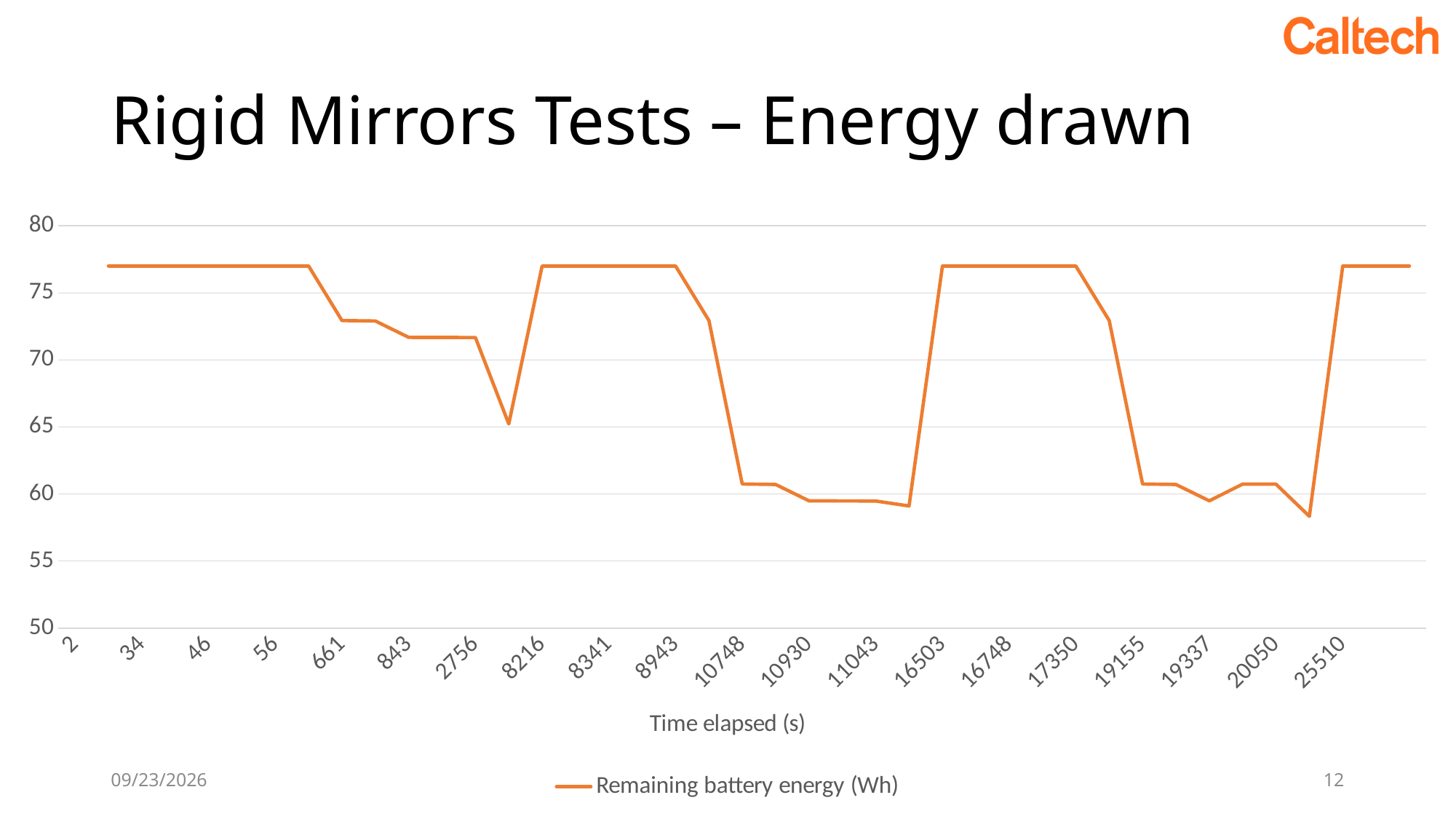
Is the value at time 661 greater or less than 75? less Do the values rise or fall between time 56 and time 2756? fall How many series does the legend list? 1 What is the title of the x axis? Time elapsed (s) What kind of chart is shown on the slide? line chart Is the value at time 10748 greater or less than 65? less Is the value at time 2756 greater or less than 70? greater What is the name of the series shown in the legend? Remaining battery energy (Wh)